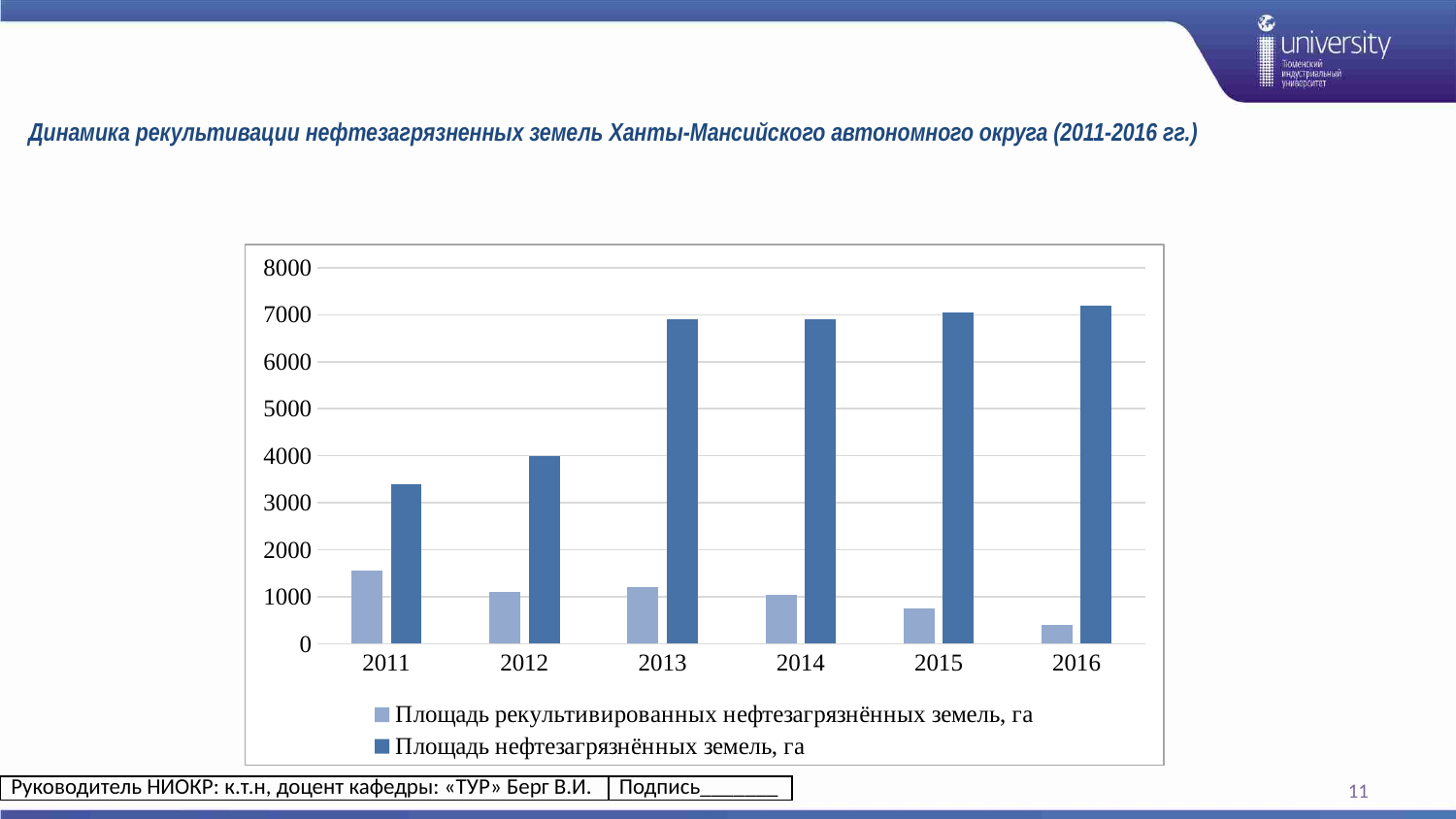
Which year has the lowest value for 'Площадь рекультивированных нефтезагрязнённых земель, га'? 2016 Is the value for 'Площадь нефтезагрязнённых земель, га' in 2011 greater or less than 3000? greater Which is larger in 2012: 'Площадь нефтезагрязнённых земель, га' or 'Площадь рекультивированных нефтезагрязнённых земель, га'? Площадь нефтезагрязнённых земель, га Which year has the lowest value for 'Площадь нефтезагрязнённых земель, га'? 2011 How many series does the legend list? 2 What is the title of the slide above the chart? Динамика рекультивации нефтезагрязненных земель Ханты-Мансийского автономного округа (2011-2016 гг.) Which year has the highest value for 'Площадь рекультивированных нефтезагрязнённых земель, га'? 2011 Does the value for 'Площадь нефтезагрязнённых земель, га' generally rise or fall from 2011 to 2016? rise What kind of chart is shown on the slide? bar chart Is the value for 'Площадь рекультивированных нефтезагрязнённых земель, га' in 2016 greater or less than 1000? less Is the value for 'Площадь нефтезагрязнённых земель, га' in 2013 greater or less than 6000? greater How many years are shown on the x axis? 6